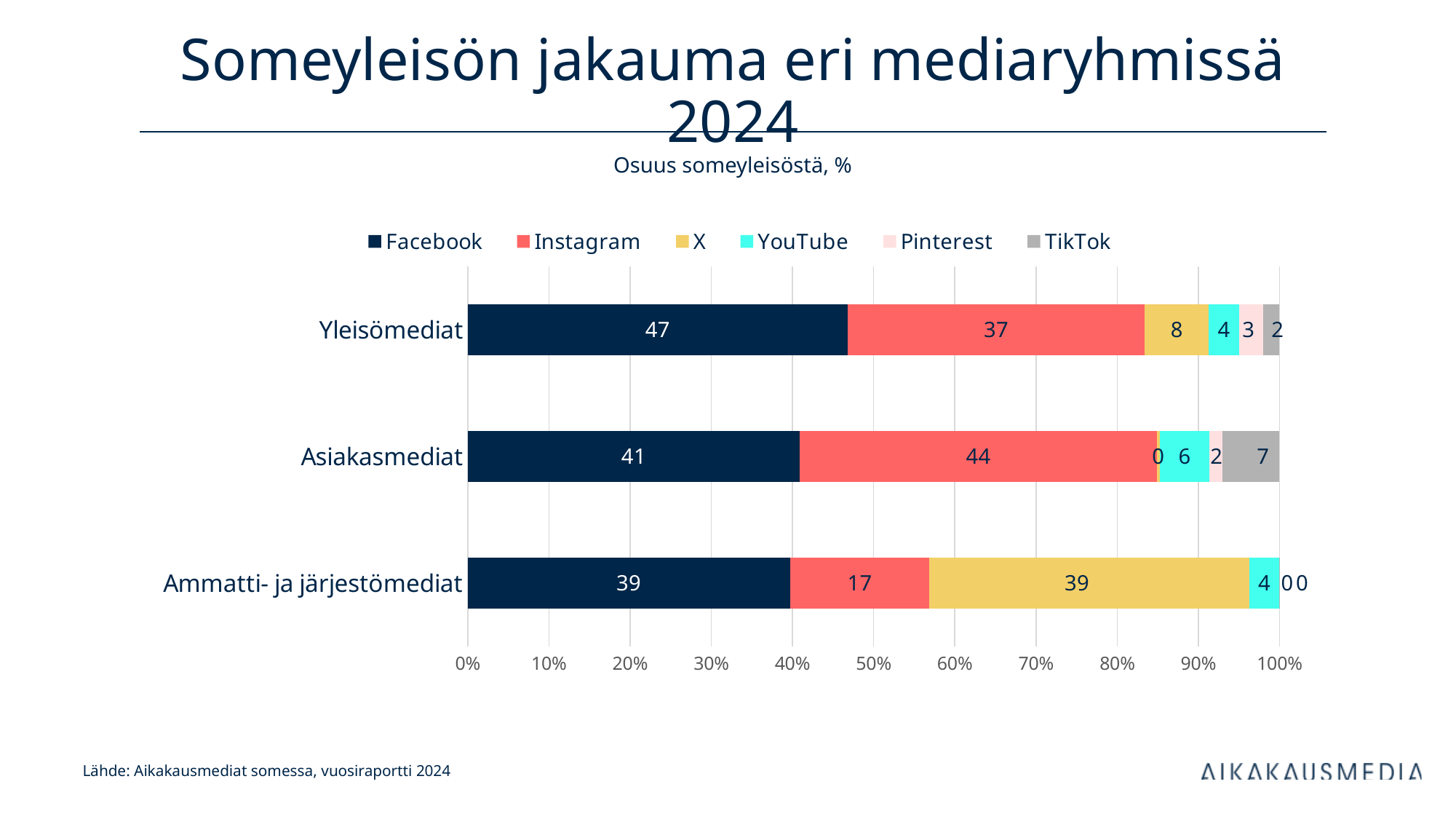
Which is larger for Yleisömediat: the Facebook share or the Instagram share? Facebook What kind of chart is shown on the slide? Stacked bar chart What is the difference between the Instagram shares of Asiakasmediat and Ammatti- ja järjestömediat? 27 How many series does the legend list? 6 What is the total of the stacked bar for Asiakasmediat? 100 What is the Instagram share for Asiakasmediat? 44 How many media groups are shown on the chart? 3 What is the TikTok share for Asiakasmediat? 7 Which media group has the lowest Instagram share? Ammatti- ja järjestömediat Which media group has the highest Facebook share? Yleisömediat What is the X share for Ammatti- ja järjestömediat? 39 What is the Facebook share for Yleisömediat? 47